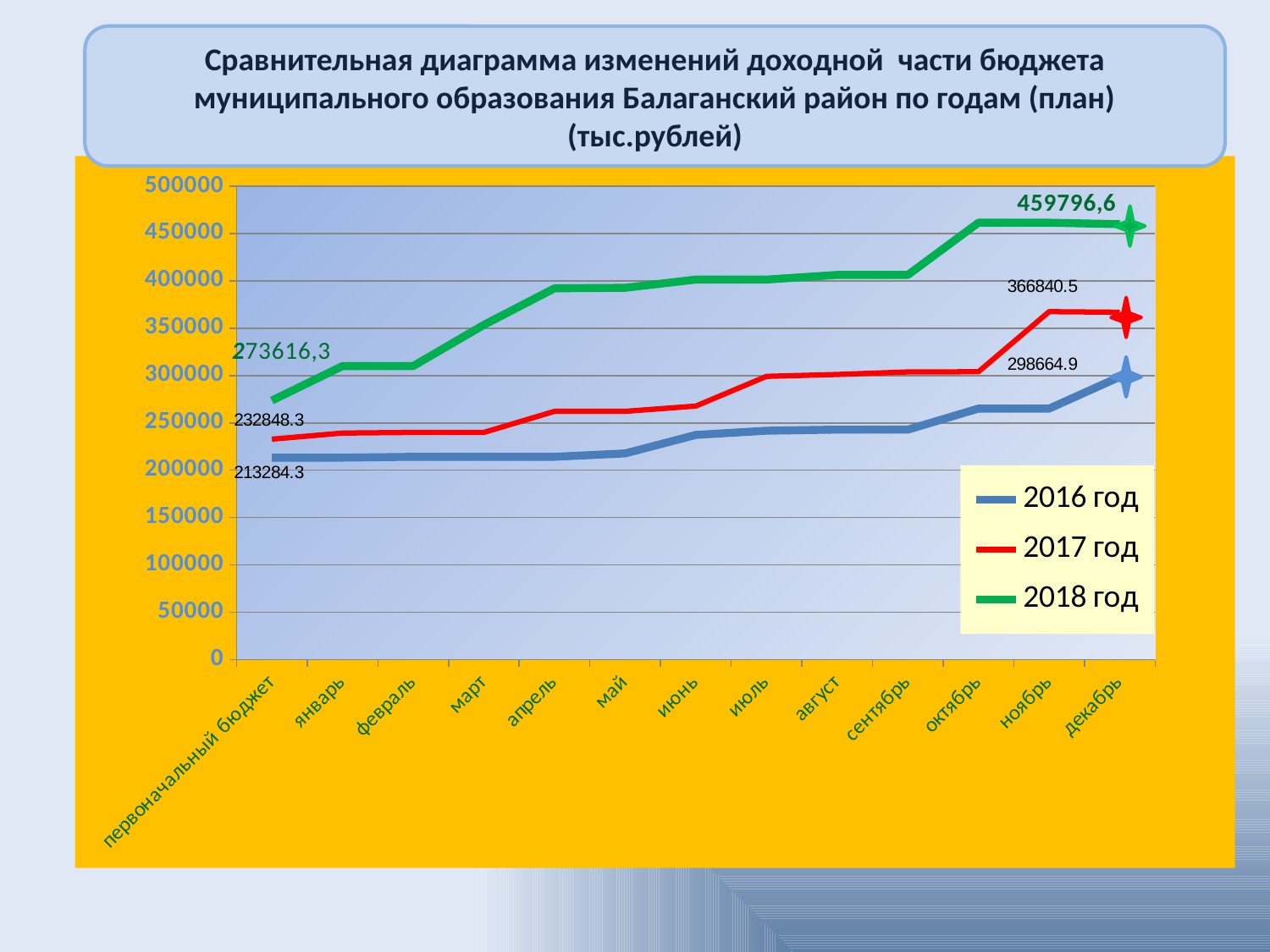
How many series does the legend list? 3 What type of chart is shown on the slide? line chart What is the value of the 2018 год series for первоначальный бюджет? 273616,3 What is the value of the 2018 год series for декабрь? 459796,6 Do the values of the 2017 год series generally rise or fall from первоначальный бюджет to декабрь? rise What is the value of the 2016 год series for первоначальный бюджет? 213284.3 Is the value of the 2018 год series for апрель greater or less than 350000? greater Which series has the highest value for декабрь? 2018 год Which series has the lowest value for первоначальный бюджет? 2016 год What is the value of the 2016 год series for декабрь? 298664.9 What is the value of the 2017 год series for декабрь? 366840.5 How many categories are shown along the x axis? 13